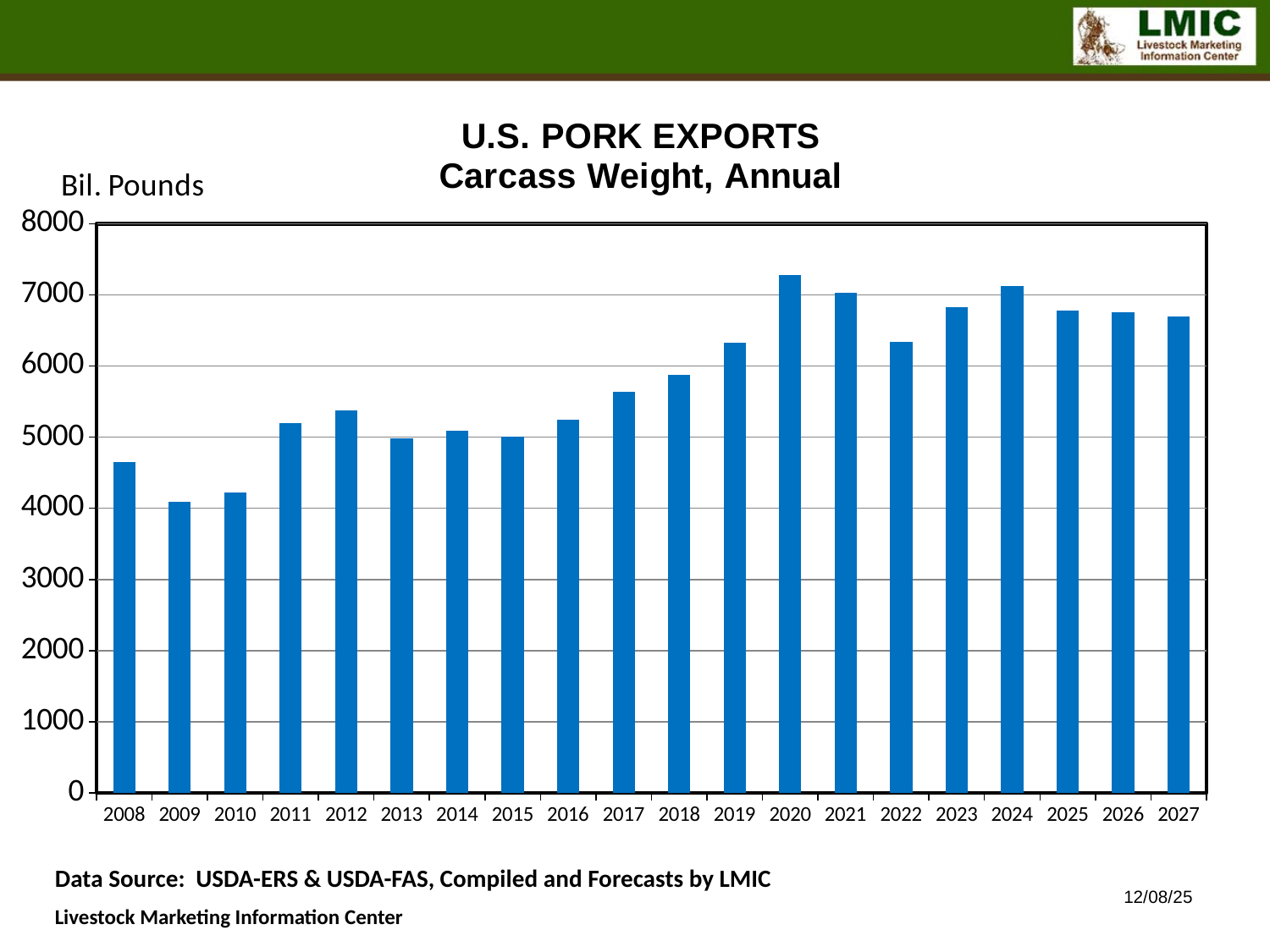
Do the values generally rise or fall from 2024 to 2027? fall What kind of chart is shown on the slide? Bar chart Which year has the lowest U.S. pork exports in the chart? 2009 Is the value for 2008 greater or less than 5000? less Is the value for 2019 greater or less than 6000? greater Which year has the larger value, 2020 or 2021? 2020 What unit is shown on the y axis of the chart? Bil. Pounds How many years are plotted on the x axis of the chart? 20 Which year has the larger value, 2008 or 2011? 2011 Which year has the highest U.S. pork exports in the chart? 2020 Is the value for 2009 greater or less than 5000? less